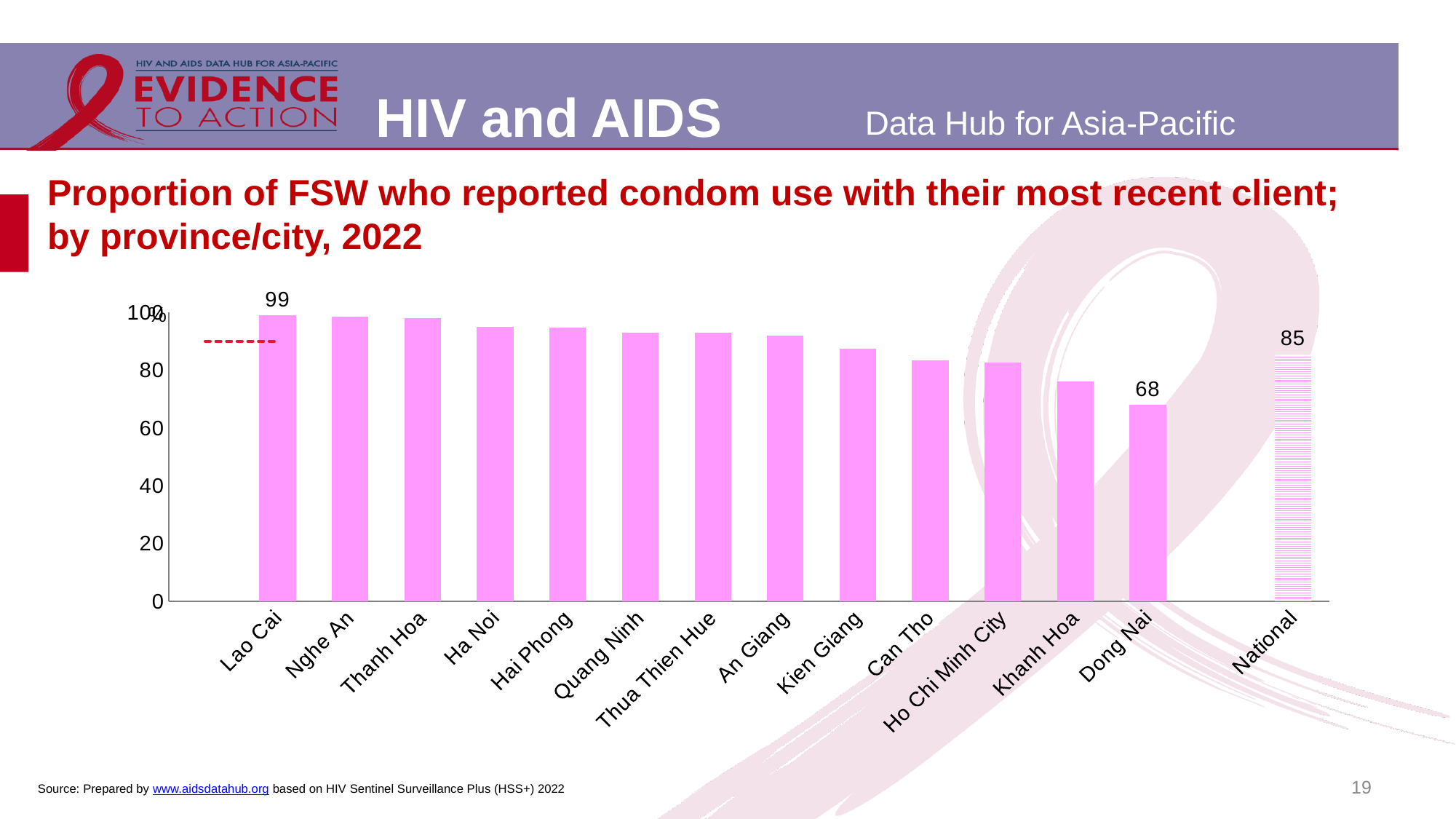
What is the value for Dong Nai? 68 What is the difference between the National value and the value for Dong Nai? 17 Which province/city has the lowest proportion in the chart? Dong Nai Is the value for Khanh Hoa greater or less than 80? less What type of chart is shown on the slide? Bar chart How many categories (bars) are shown on the x axis, including National? 14 What is the National value shown in the chart? 85 Do the values for the provinces/cities rise or fall from left to right along the x axis? Fall Which is larger, the value for Lao Cai or the value for Dong Nai? Lao Cai What is the value for Lao Cai? 99 What is the difference between the values for Lao Cai and Dong Nai? 31 Is the value for Kien Giang greater or less than 80? greater